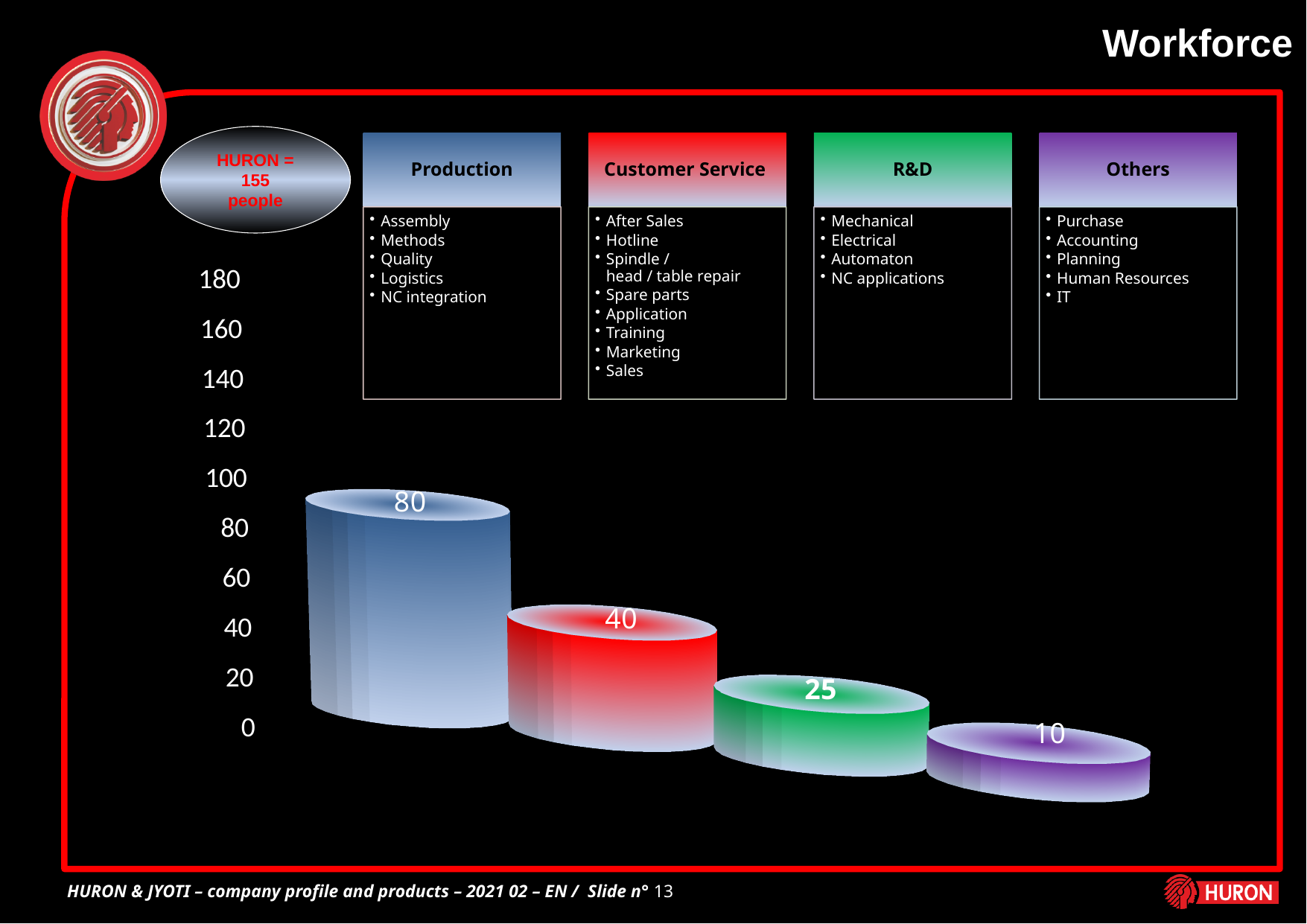
What is the workforce value for Customer Service? 40 What kind of chart is shown on the slide? Bar chart What is the workforce value for Others? 10 How many departments are plotted in the chart? 4 What is the difference between the R&D and Others workforce values? 15 Which department has the largest workforce? Production Which department has the smallest workforce? Others Which is larger, the workforce for Customer Service or for R&D? Customer Service Do the values rise or fall from left to right across the chart? Fall What is the workforce value for R&D? 25 What is the workforce value for Production? 80 What is the difference between the Production and Customer Service workforce values? 40